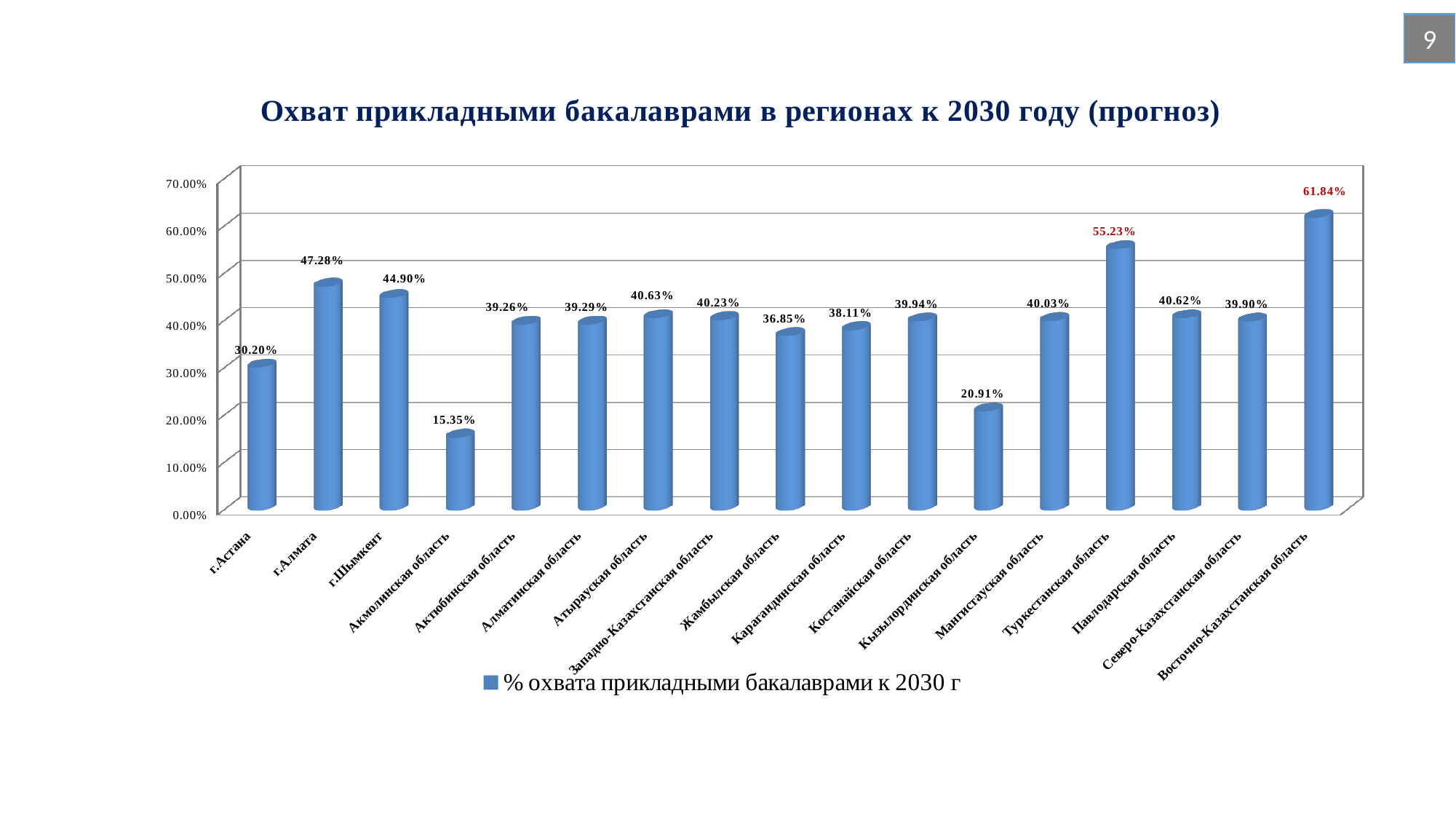
What is the difference between the values for Восточно-Казахстанская область and Туркестанская область? 6.61% How many series does the legend list? 1 Which region has the highest value? Восточно-Казахстанская область Which region has the lowest value? Акмолинская область What is the value for Акмолинская область? 15.35% What is the value for Кызылординская область? 20.91% What is the title of the chart? Охват прикладными бакалаврами в регионах к 2030 году (прогноз) What is the value for Туркестанская область? 55.23% What is the value for г.Алмата? 47.28% Which is larger, the value for г.Алмата or the value for г.Шымкент? г.Алмата What kind of chart is shown on the slide? Bar chart How many regions are shown on the x axis? 17